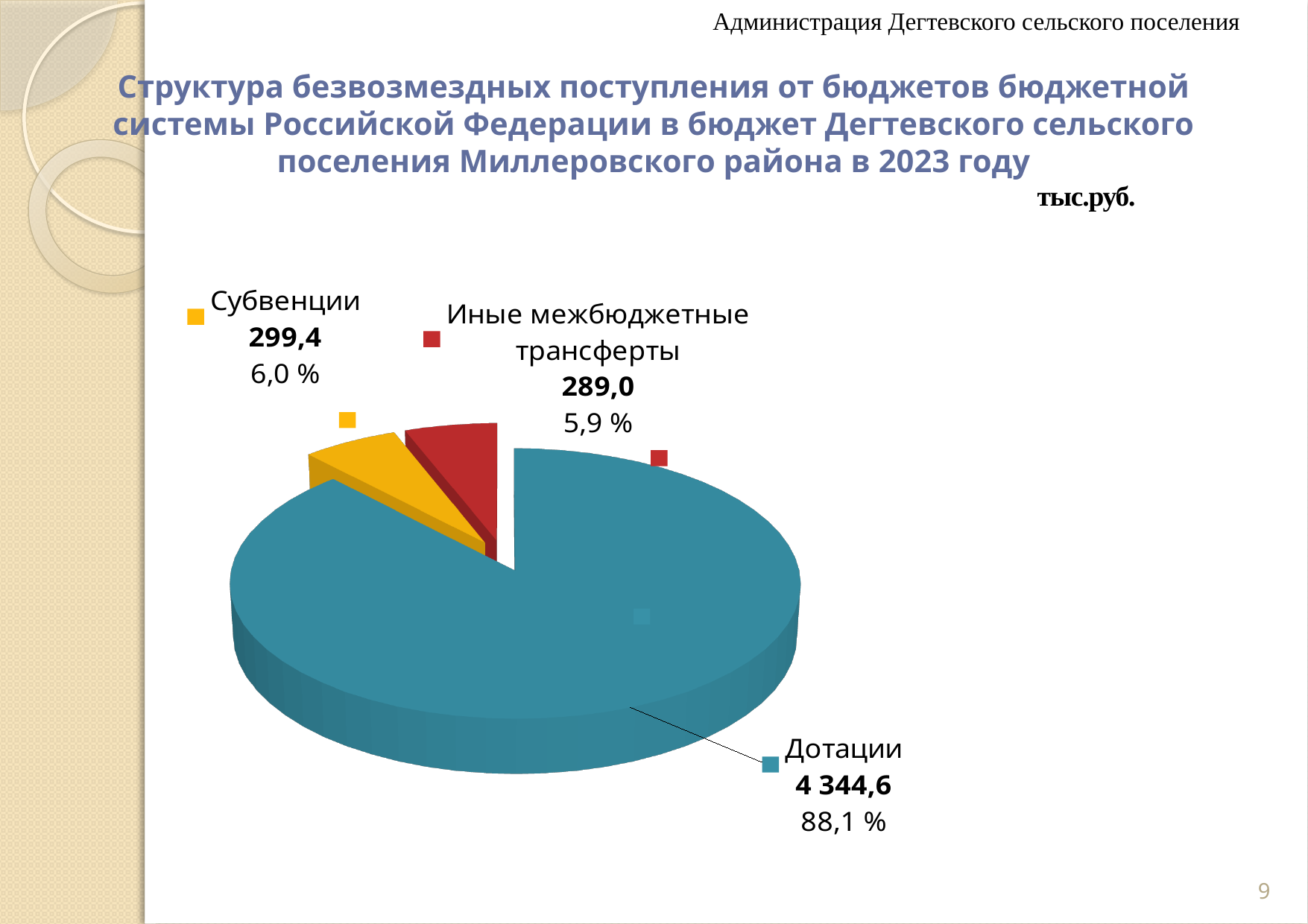
Which category has the smallest value? Иные межбюджетные трансферты What kind of chart is shown on the slide? Pie chart What share of the pie does Дотации represent? 88,1 % How many slices does the pie chart have? 3 What is the difference between the values for Дотации and Субвенции? 4 045,2 What is the value for Иные межбюджетные трансферты? 289,0 What is the value for Дотации? 4 344,6 What is the difference between the values for Субвенции and Иные межбюджетные трансферты? 10,4 What share of the pie does Иные межбюджетные трансферты represent? 5,9 % Which category has the largest slice? Дотации What is the value for Субвенции? 299,4 What unit of measurement is indicated for the chart values? тыс.руб.